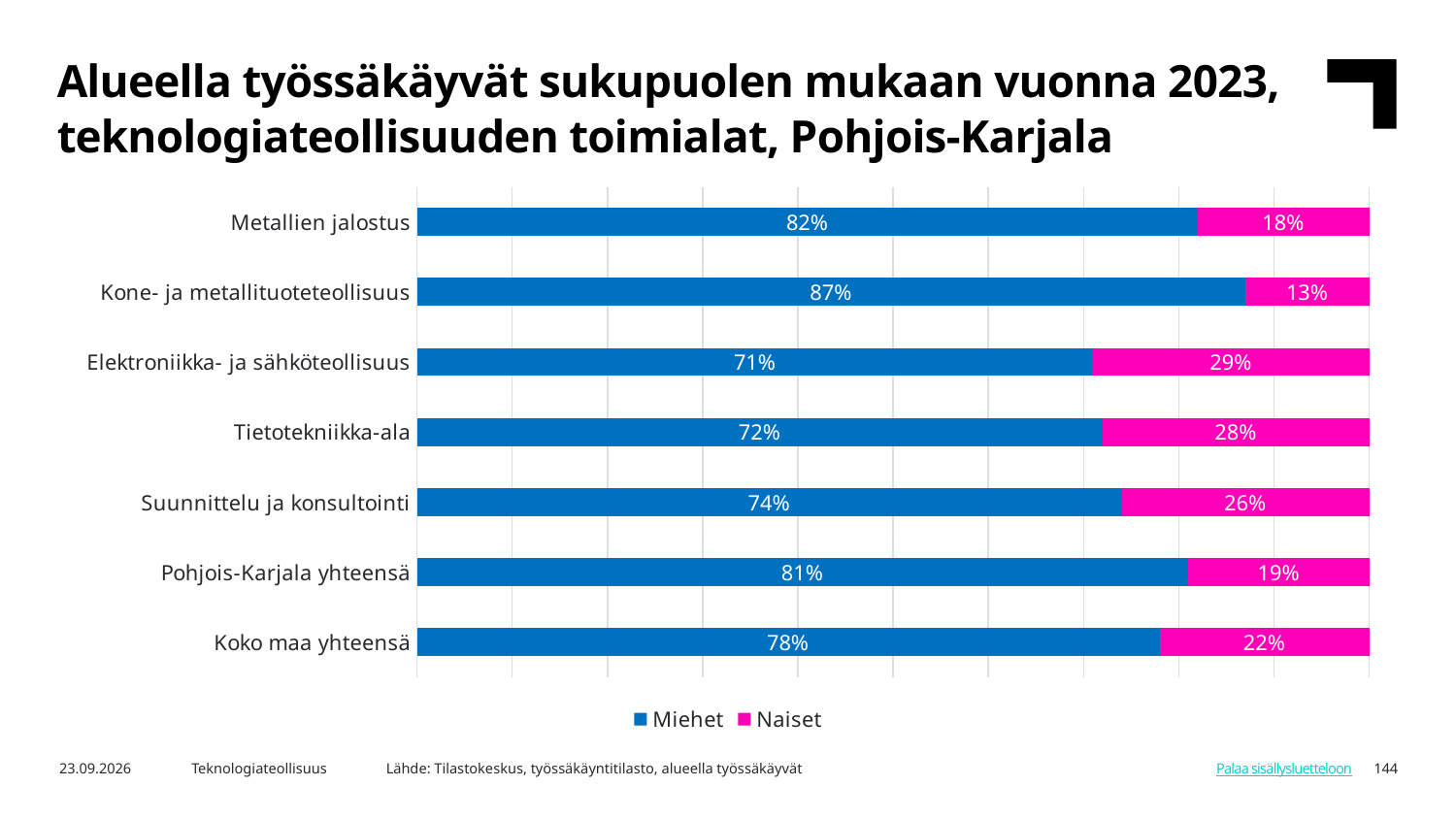
How many categories are shown on the chart? 7 Which colour represents Naiset in the chart? Pink (magenta) What kind of chart is shown on the slide? Stacked bar chart What is the Naiset share for Koko maa yhteensä? 22% What is the difference between the Miehet share for Pohjois-Karjala yhteensä and Koko maa yhteensä? 3 percentage points Which is larger: the Naiset share for Tietotekniikka-ala or for Suunnittelu ja konsultointi? Tietotekniikka-ala Which category has the highest Miehet share? Kone- ja metallituoteteollisuus What is the Miehet share for Metallien jalostus? 82% Which category has the lowest Naiset share? Kone- ja metallituoteteollisuus What is the Naiset share for Elektroniikka- ja sähköteollisuus? 29% How many series does the legend list? 2 What is the total of the stacked bar for Elektroniikka- ja sähköteollisuus? 100%